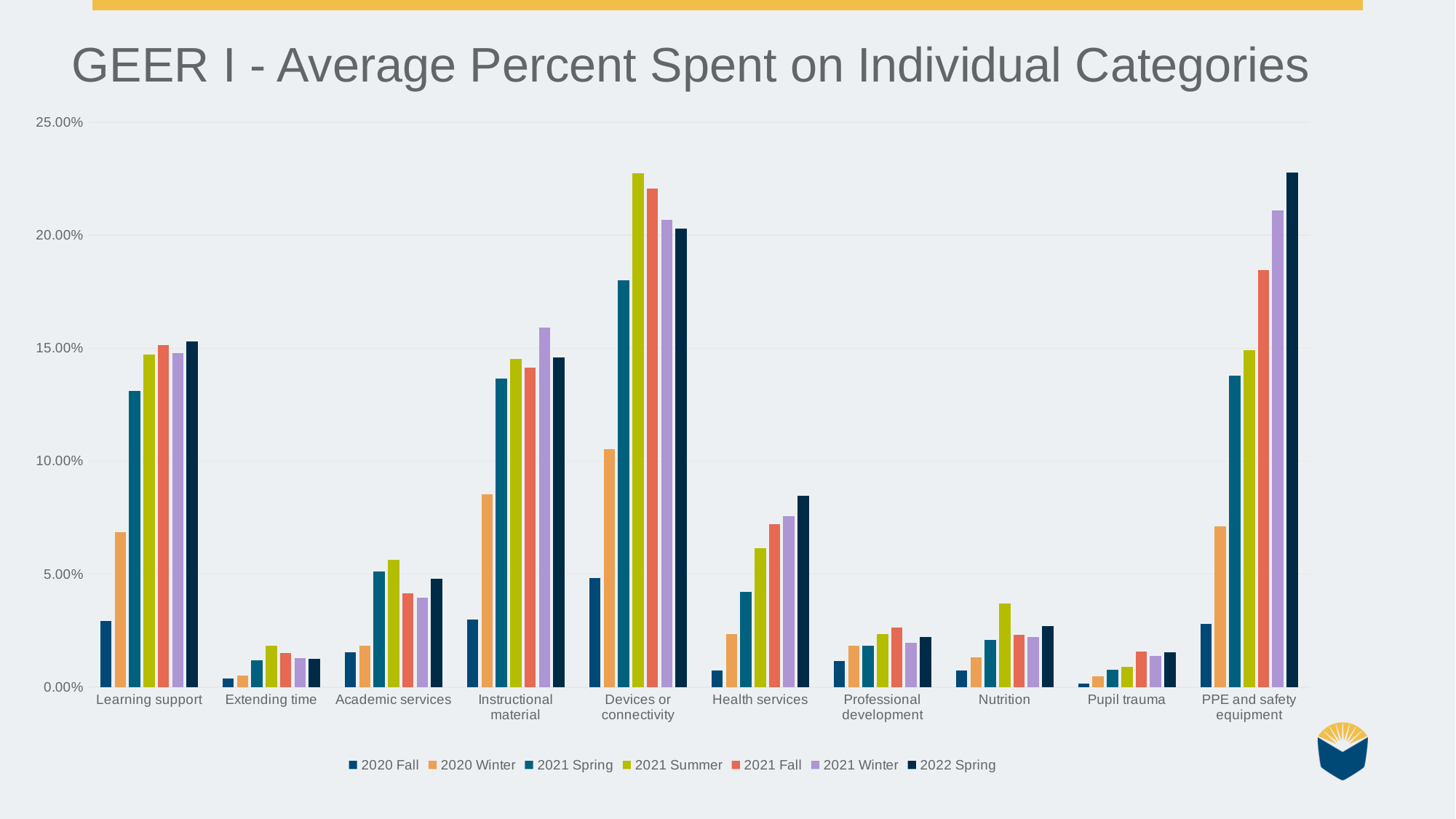
How many spending categories are shown on the x axis? 10 For Learning support, which is larger: the 2021 Spring value or the 2020 Winter value? 2021 Spring Which series has the highest value for Devices or connectivity? 2021 Summer Is the 2021 Spring value for Devices or connectivity greater or less than 15.00%? greater What kind of chart is shown on the slide? bar chart For 2022 Spring, which is larger: the Health services value or the Nutrition value? Health services Which series has the highest value for PPE and safety equipment? 2022 Spring Is the 2020 Fall value for Learning support greater or less than 5.00%? less Is the 2021 Summer value for Devices or connectivity greater or less than 20.00%? greater What is the title of the chart? GEER I - Average Percent Spent on Individual Categories Which series has the lowest value for Pupil trauma? 2020 Fall How many series does the legend list? 7